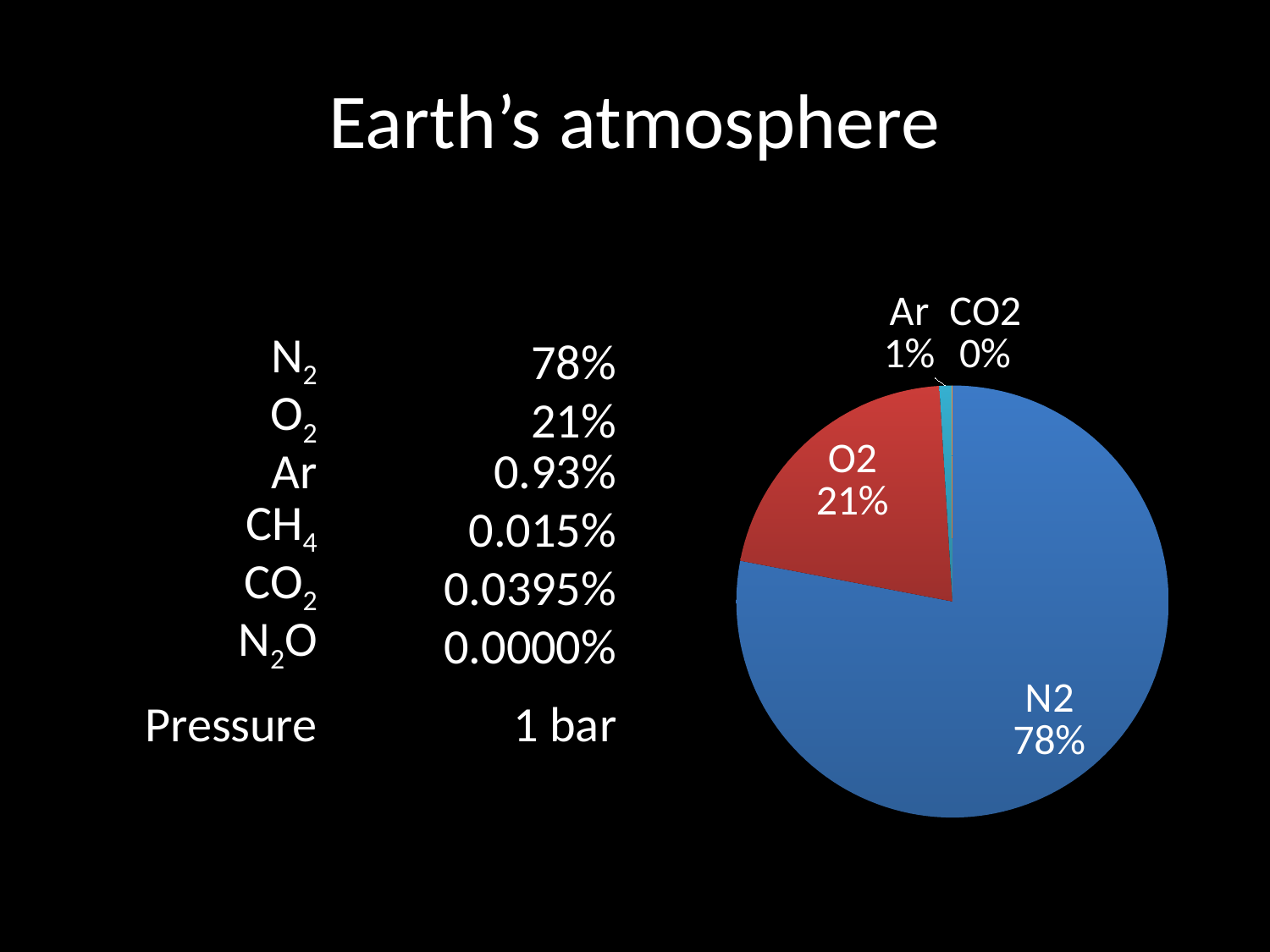
What percentage does the pie chart show for CO2? 0% What percentage does the pie chart show for O2? 21% What colour is the N2 slice in the pie chart? blue What colour is the O2 slice in the pie chart? red What percentage does the pie chart show for N2? 78% Which gas has the smallest slice in the pie chart? CO2 How many slices are labelled in the pie chart? 4 In the pie chart, which slice is larger, O2 or Ar? O2 What percentage does the pie chart show for Ar? 1% What type of chart is shown on the slide? pie chart In the pie chart, what is the difference between the N2 and O2 percentages? 57% Which gas has the largest slice in the pie chart? N2